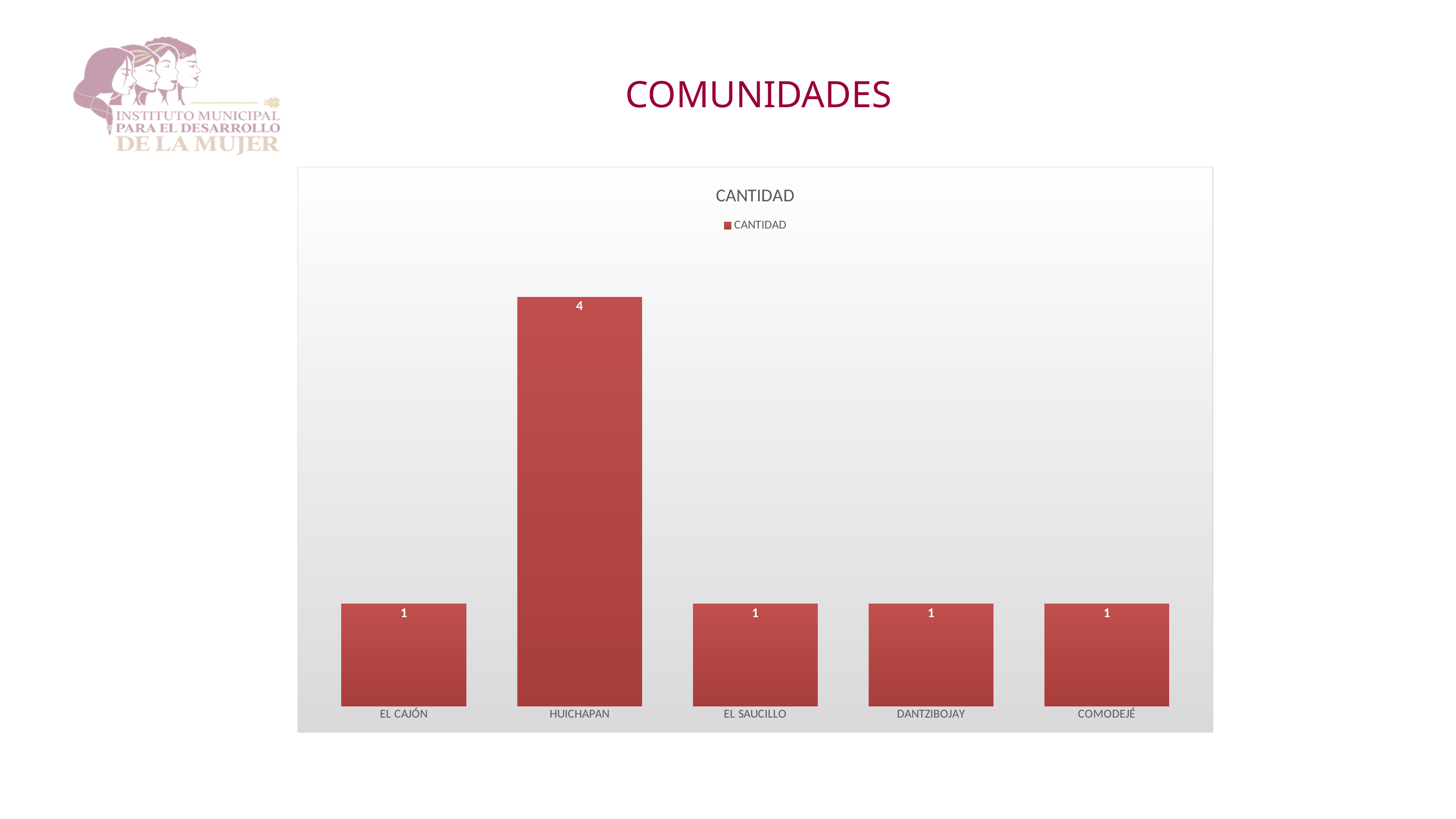
What is the value for COMODEJÉ? 1 What is the total of all the values shown in the chart? 8 What is the value for HUICHAPAN? 4 What is the value for EL CAJÓN? 1 What is the difference between the values for HUICHAPAN and EL SAUCILLO? 3 What is the name of the series listed in the legend? CANTIDAD How many categories are shown on the x axis? 5 Which is larger, the value for HUICHAPAN or the value for DANTZIBOJAY? HUICHAPAN What is the title of the chart? CANTIDAD Which category has the highest value? HUICHAPAN What kind of chart is shown? bar chart How many series does the legend list? 1